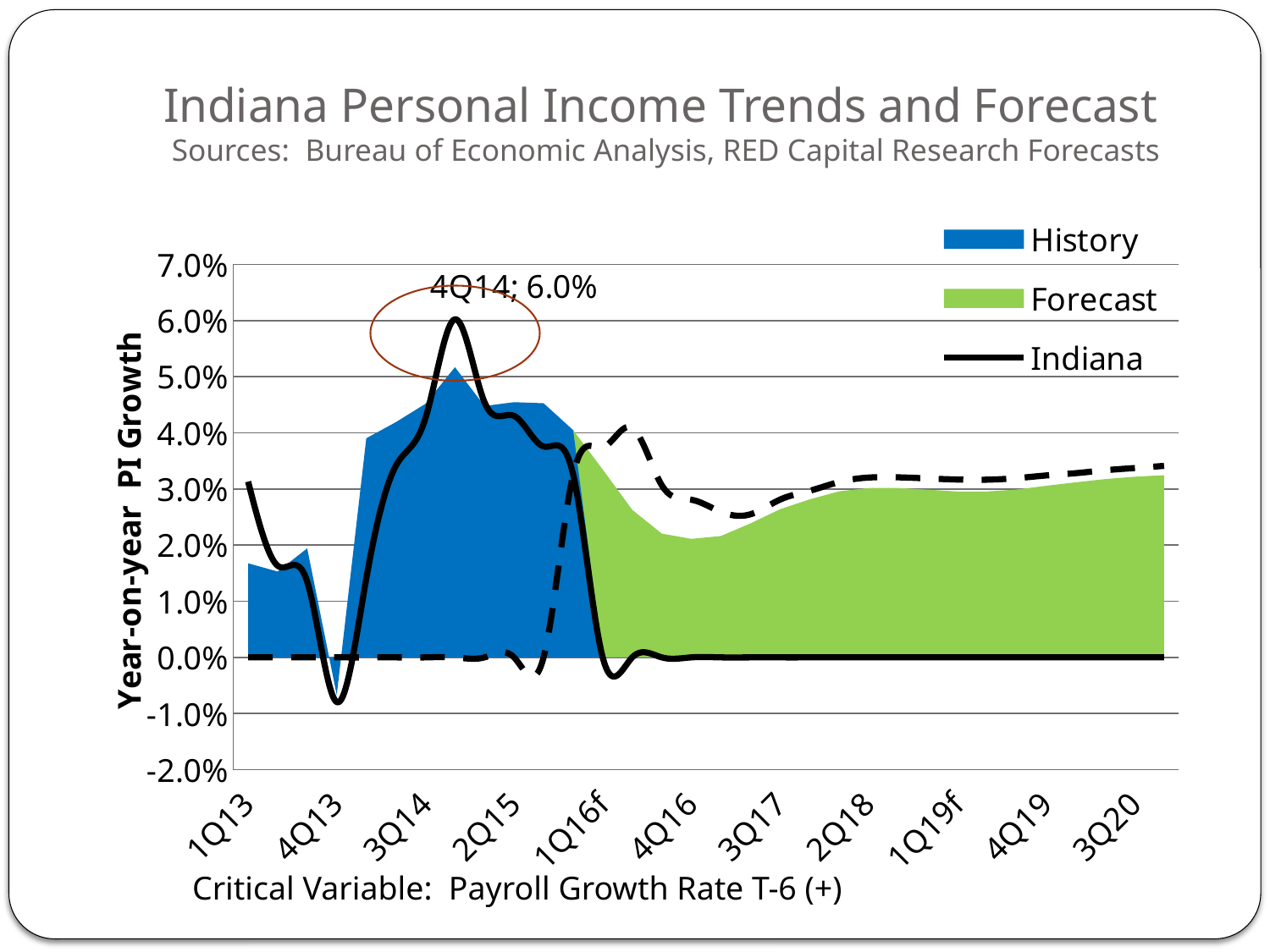
How many quarter labels are shown on the x axis? 11 What value is labeled for the Indiana line at 4Q14? 6.0% Is the Indiana value at 1Q13 greater or less than 2.0%? greater What is the title of the chart? Indiana Personal Income Trends and Forecast What is the label on the vertical axis? Year-on-year PI Growth In which quarter does the Indiana line reach its highest value? 4Q14 How many series does the legend list? 3 Which is larger, the Indiana value at 4Q14 or at 1Q13? 4Q14 Is the lowest point of the Indiana line greater or less than 0.0%? less Is the History value at 3Q14 greater or less than 3.0%? greater Does the Forecast area rise or fall from 4Q16 to 3Q20? rise